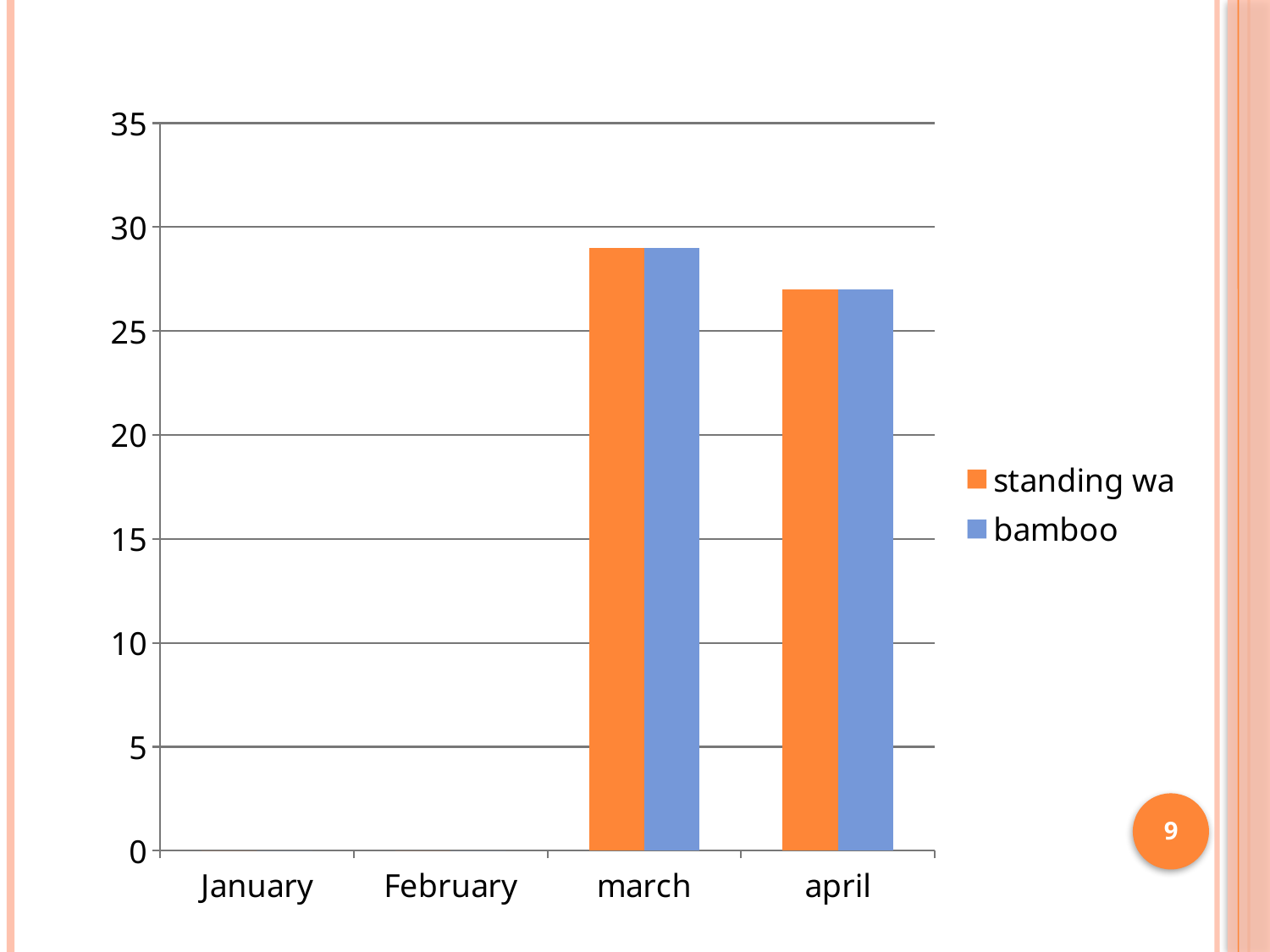
Is the value for standing wa in march greater or less than 30? less Do the values for the standing wa series rise or fall from march to april? fall Which is larger for the bamboo series: march or april? march How many series does the legend list? 2 What kind of chart is shown on the slide? bar chart Is the value for bamboo in march greater or less than 25? greater How many categories are shown on the x axis? 4 Is the value for bamboo in april greater or less than 25? greater Which colour represents the bamboo series in the legend? blue Which category has the highest value for the standing wa series? march Which category has the highest value for the bamboo series? march